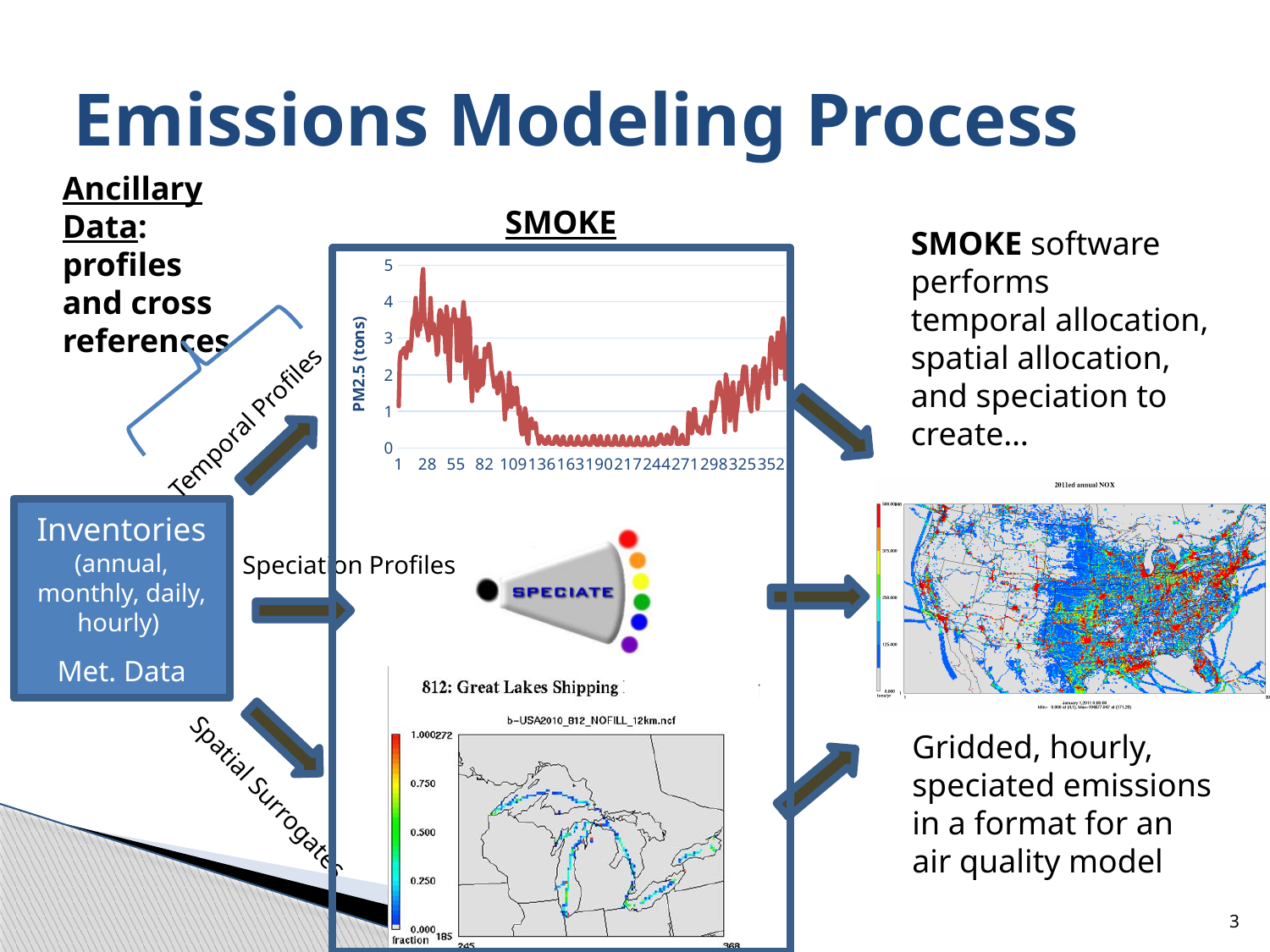
In the PM2.5 line chart, is the value around x = 244 greater or less than 2? less In the PM2.5 line chart, is the value around x = 190 greater or less than 1? less What is the last tick label on the horizontal axis of the PM2.5 line chart? 352 What is the first tick label on the horizontal axis of the PM2.5 line chart? 1 In the PM2.5 line chart, do the values rise or fall between x = 55 and x = 136? fall In the PM2.5 line chart, is the peak value near x = 28 greater or less than 4? greater What is the label on the vertical axis of the line chart in the SMOKE box? PM2.5 (tons) What kind of chart is shown inside the SMOKE box at the top of the slide? line chart In the PM2.5 line chart, do the values rise or fall between x = 271 and x = 352? rise What is the highest value shown on the vertical axis of the PM2.5 line chart? 5 In the PM2.5 line chart, are the values near x = 28 higher or lower than the values near x = 217? higher How many tick labels are printed along the horizontal axis of the PM2.5 line chart? 14